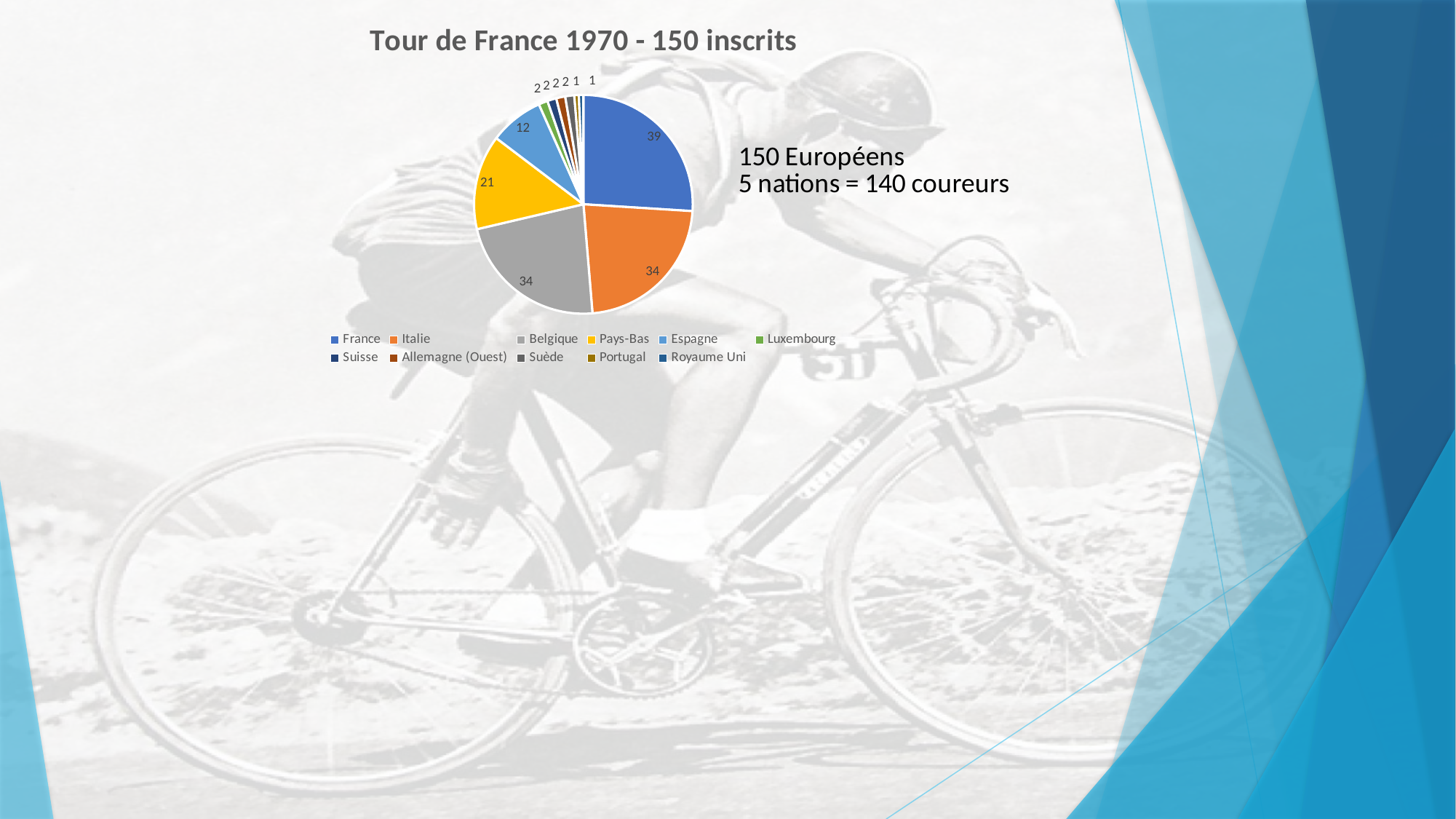
What type of chart is shown on the slide? pie chart What share of the 150 riders does France represent? 26% What is the difference between the number of riders for Pays-Bas and for Espagne? 9 How many countries are listed in the chart legend? 11 How many riders does the chart show for Espagne? 12 Which country has the largest slice of the pie? France How many riders does the chart show for Pays-Bas? 21 How many riders does the chart show for Italie? 34 What is the difference between the number of riders for France and for Italie? 5 How many riders does the chart show for France? 39 Which is larger, the slice for Pays-Bas or the slice for Espagne? Pays-Bas What is the title of the chart? Tour de France 1970 - 150 inscrits